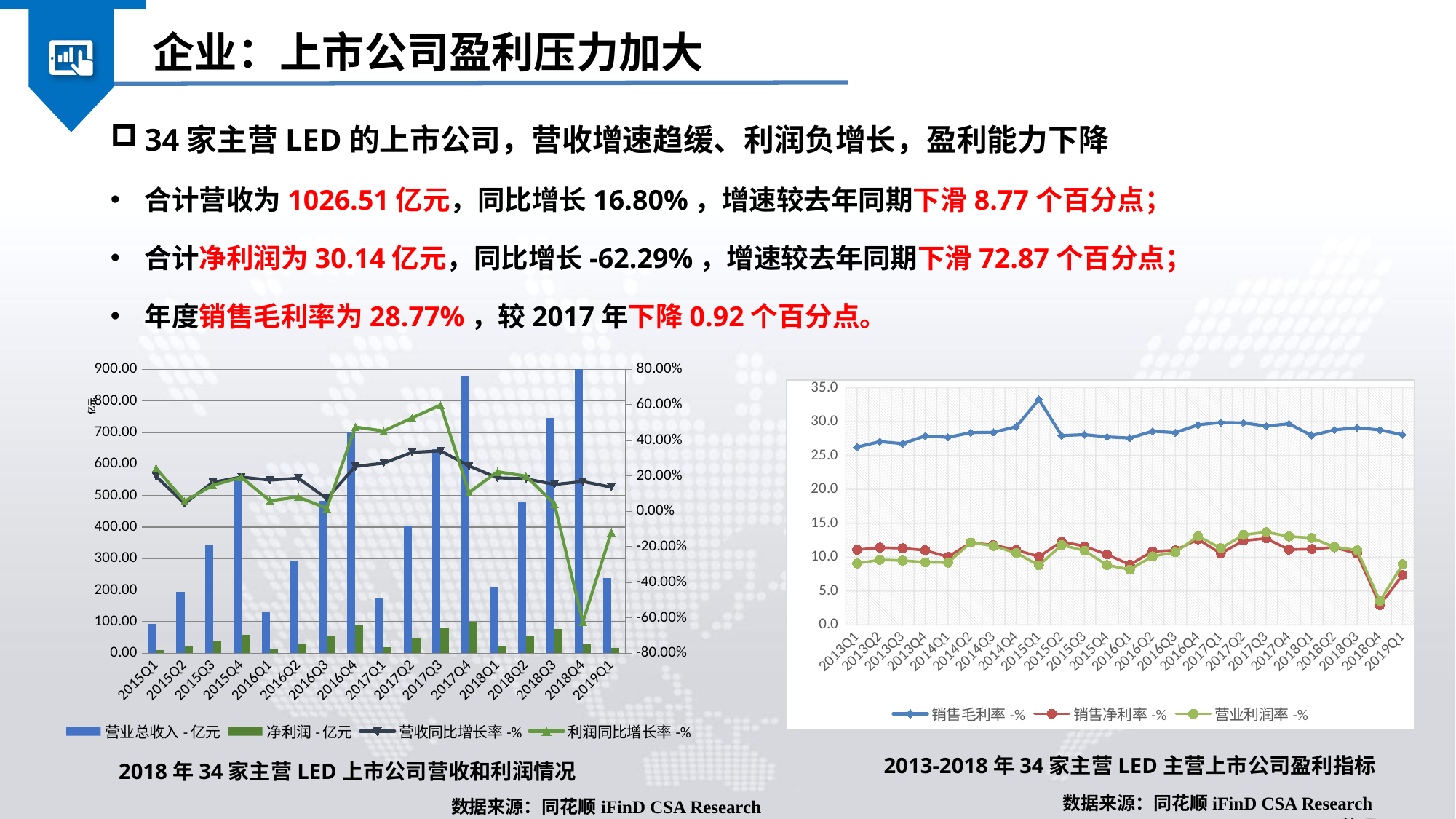
In the left chart (2018年34家主营LED上市公司营收和利润情况), how many series does the legend list? 4 In the right chart (2013-2018年34家主营LED主营上市公司盈利指标), which quarter has the highest 销售毛利率 value? 2015Q1 In the left chart (2018年34家主营LED上市公司营收和利润情况), is the 营业总收入 value for 2016Q3 greater or less than 400? greater In the right chart (2013-2018年34家主营LED主营上市公司盈利指标), how many series does the legend list? 3 In the left chart (2018年34家主营LED上市公司营收和利润情况), how many quarters are shown on the x axis? 17 In the left chart (2018年34家主营LED上市公司营收和利润情况), which is larger, the 营业总收入 bar for 2018Q3 or for 2018Q2? 2018Q3 In the left chart (2018年34家主营LED上市公司营收和利润情况), which quarter has the lowest 营业总收入 bar? 2015Q1 In the right chart (2013-2018年34家主营LED主营上市公司盈利指标), is the 销售净利率 value for 2018Q4 greater or less than 5.0? less In the left chart (2018年34家主营LED上市公司营收和利润情况), is the 利润同比增长率 value for 2018Q4 greater or less than -40.00%? less In the left chart (2018年34家主营LED上市公司营收和利润情况), which quarter has the lowest 利润同比增长率 value? 2018Q4 What type of chart is the right chart (2013-2018年34家主营LED主营上市公司盈利指标)? line chart